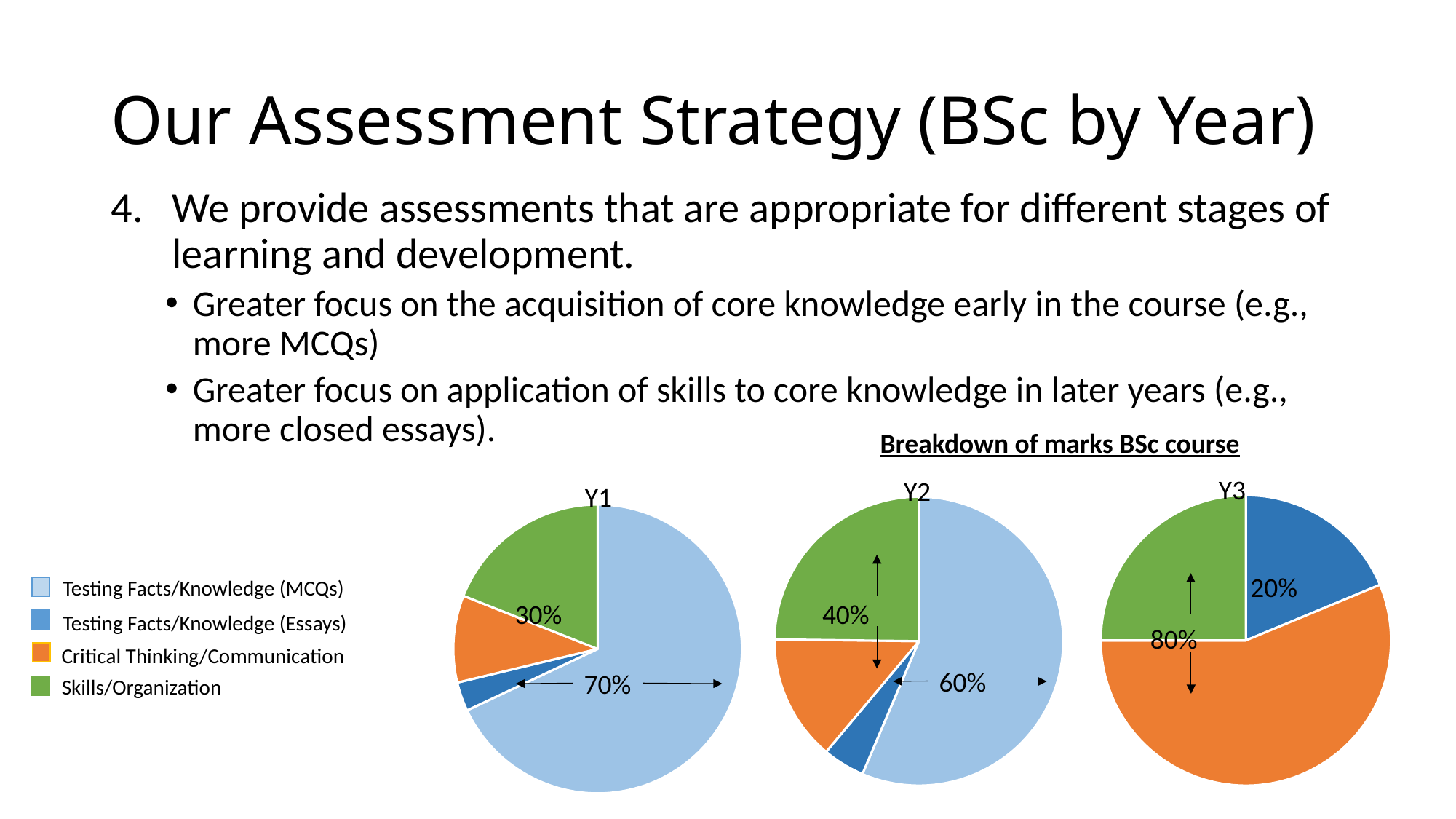
What is the title shown above the pie charts? Breakdown of marks BSc course What kind of charts are shown on the slide? Pie charts In the Y1 pie chart, what percentage is labelled for Testing Facts/Knowledge (MCQs)? 70% How many categories does the legend list for the pie charts? 4 In the Y1 pie chart, which category has the largest slice? Testing Facts/Knowledge (MCQs) In the Y3 pie chart, what percentage is labelled for Testing Facts/Knowledge (Essays)? 20% How many pie charts are shown on the slide? 3 In the Y3 pie chart, which category has the largest slice? Critical Thinking/Communication By how many percentage points does the MCQs share fall from the Y1 pie chart to the Y2 pie chart? 10 In the Y2 pie chart, what percentage is labelled for Testing Facts/Knowledge (MCQs)? 60% In the Y1 pie chart, which category has the smallest slice? Testing Facts/Knowledge (Essays) Is the MCQs share larger in the Y1 pie chart or the Y2 pie chart? Y1